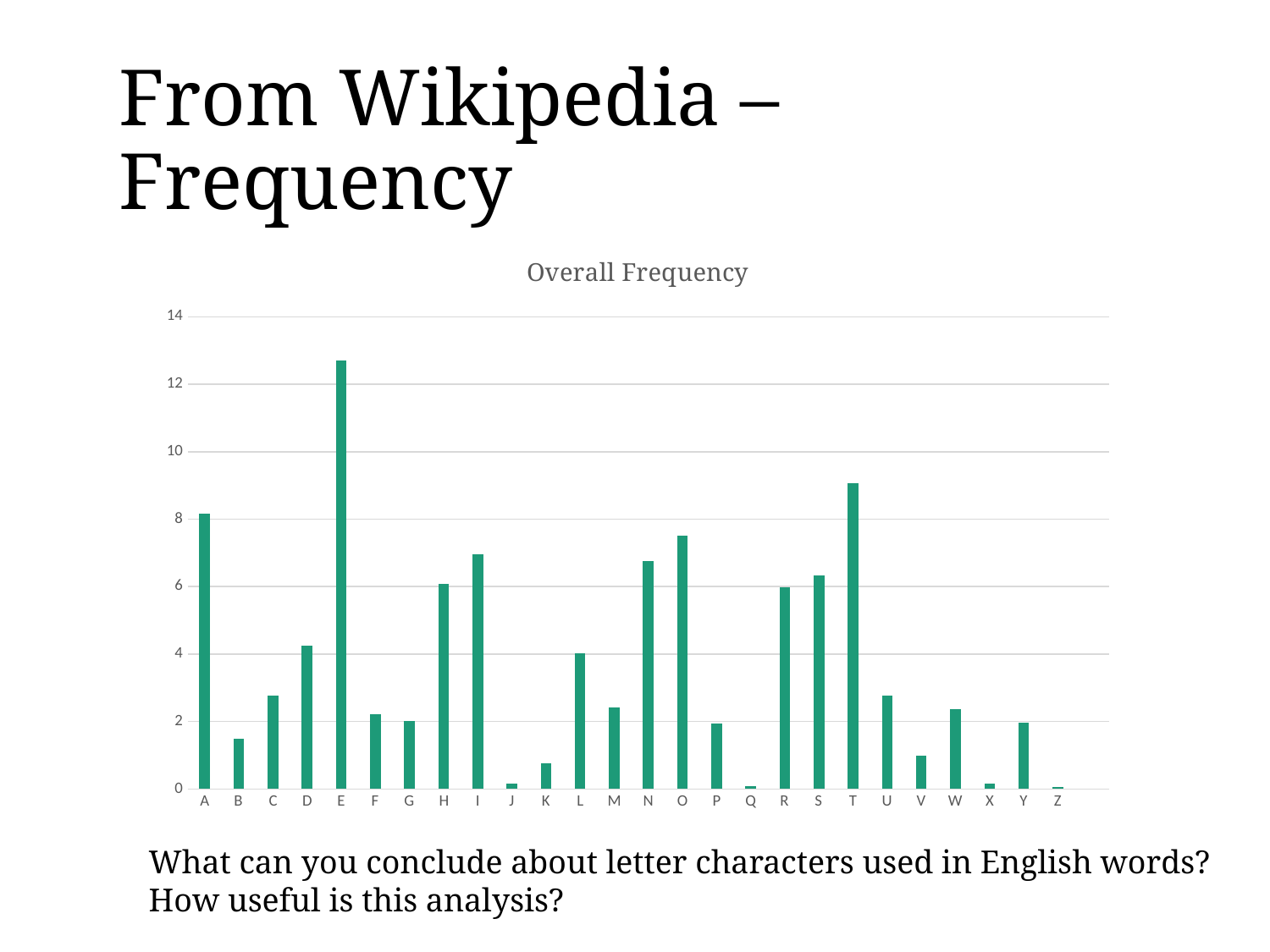
Is the value for V greater or less than 2? less Is the value for I greater or less than 8? less Is the value for E greater or less than 12? greater What kind of chart is shown on the slide? bar chart Which has the larger value, T or A? T What is the title of the chart? Overall Frequency Which letter has the highest overall frequency? E Which has the larger value, O or I? O How many letter categories are plotted on the x axis? 26